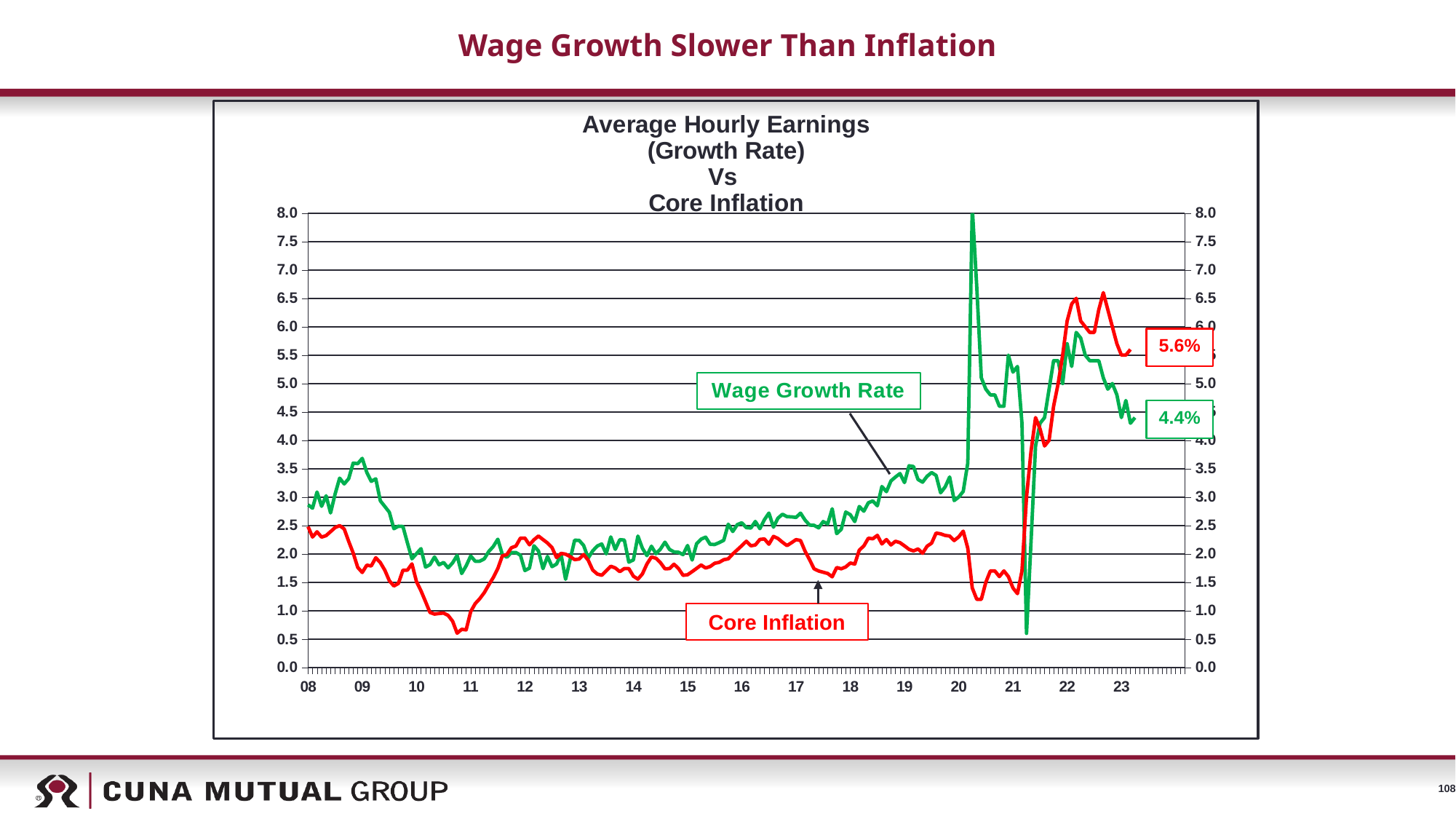
Is the peak of Core Inflation in 2022 greater or less than 6.0? greater How many data series are plotted on the chart? 2 Is the peak of the Wage Growth Rate around 2020 greater or less than 7.0? greater What kind of chart is shown on the slide? Line chart What is the difference between the latest labelled Core Inflation value and the latest labelled Wage Growth Rate value? 1.2 percentage points Which series reaches the highest value anywhere on the chart? Wage Growth Rate Does Core Inflation rise or fall between 2021 and 2022? rise Is the lowest Core Inflation value around 2011 greater or less than 1.0? less What colour is the Wage Growth Rate line? Green What is the latest labelled value for the Wage Growth Rate? 4.4% What is the latest labelled value for Core Inflation? 5.6% At the end of the chart, which is higher: Core Inflation or the Wage Growth Rate? Core Inflation